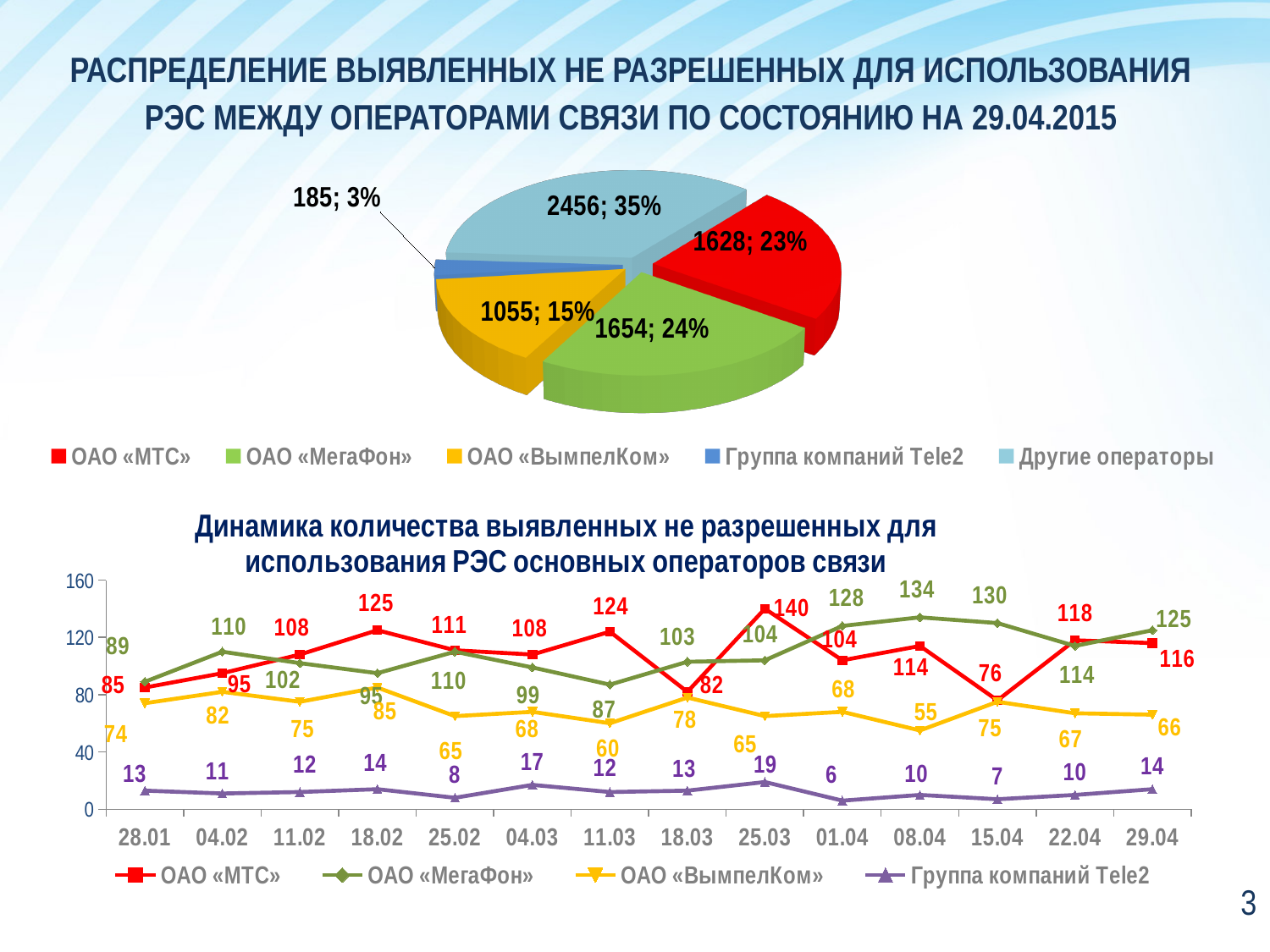
In the line chart 'Динамика количества выявленных не разрешенных для использования РЭС основных операторов связи', which is larger on 22.04: the value for ОАО «МТС» or ОАО «МегаФон»? ОАО «МТС» In the pie chart at the top of the slide, which category has the largest slice? Другие операторы In the pie chart at the top of the slide, how many categories does the legend list? 5 In the pie chart at the top of the slide, what value is shown for ОАО «МегаФон»? 1654; 24% In the line chart 'Динамика количества выявленных не разрешенных для использования РЭС основных операторов связи', on which date does ОАО «МегаФон» reach its highest value? 08.04 In the line chart 'Динамика количества выявленных не разрешенных для использования РЭС основных операторов связи', what is the value for Группа компаний Tele2 on 01.04? 6 In the line chart 'Динамика количества выявленных не разрешенных для использования РЭС основных операторов связи', what is the value for ОАО «МТС» on 25.03? 140 In the pie chart at the top of the slide, which category has the smallest slice? Группа компаний Tele2 In the pie chart at the top of the slide, what is the difference between the values for ОАО «МТС» and ОАО «ВымпелКом»? 573 In the line chart 'Динамика количества выявленных не разрешенных для использования РЭС основных операторов связи', how many series does the legend list? 4 In the line chart 'Динамика количества выявленных не разрешенных для использования РЭС основных операторов связи', how many dates are shown on the x axis? 14 In the pie chart at the top of the slide, what share does Группа компаний Tele2 have? 3%